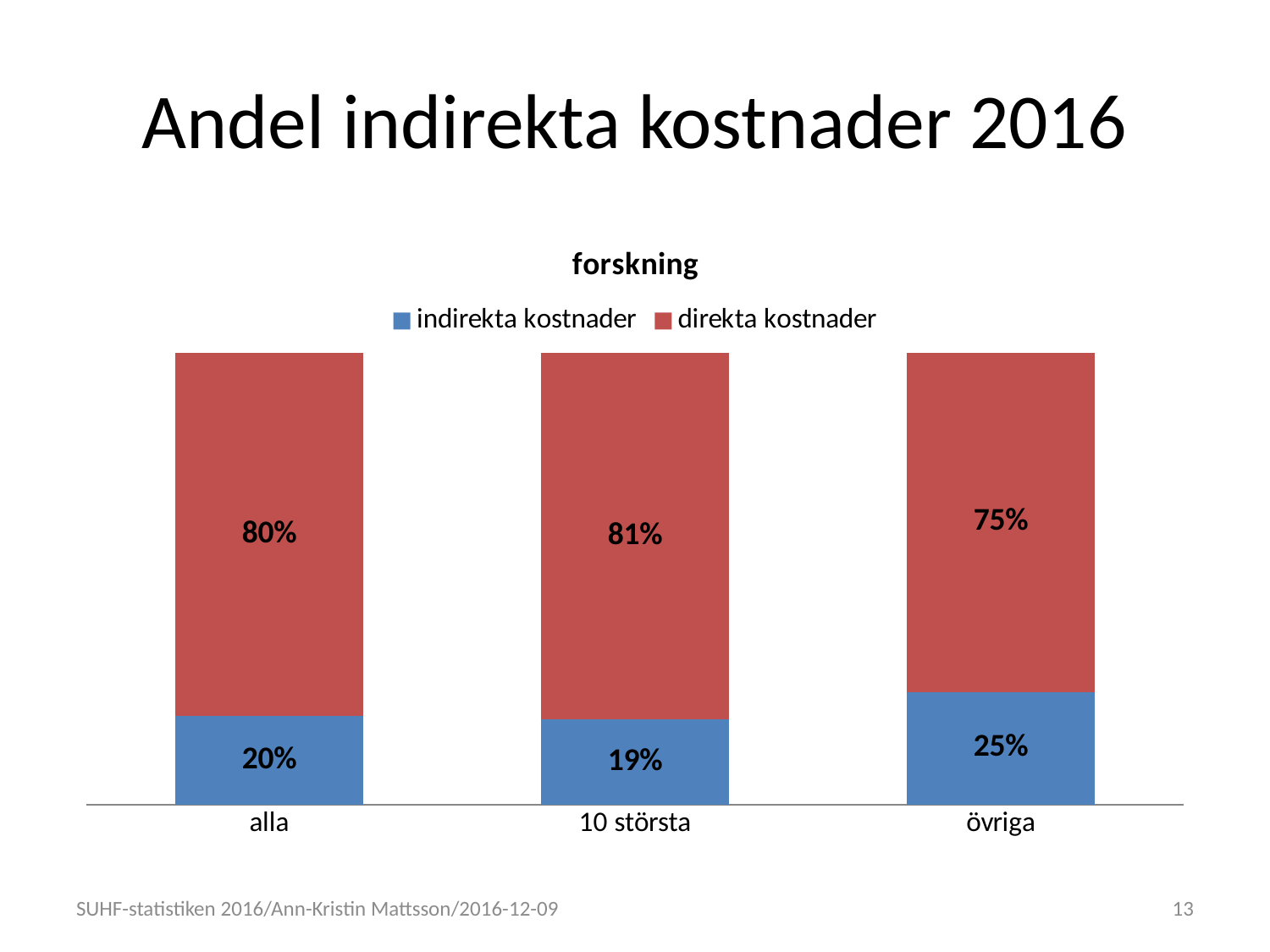
What is the difference between the indirekta kostnader share for övriga and for 10 största? 6% What is the value of direkta kostnader for alla? 80% How many series does the legend list? 2 What is the value of indirekta kostnader for övriga? 25% What is the value of direkta kostnader for 10 största? 81% How many categories are shown on the x axis? 3 What is the title of the chart? forskning What kind of chart is shown on the slide? stacked bar chart Which is larger: the direkta kostnader share for alla or for övriga? alla Which category has the lowest share of direkta kostnader? övriga What is the value of indirekta kostnader for alla? 20% Which category has the highest share of indirekta kostnader? övriga